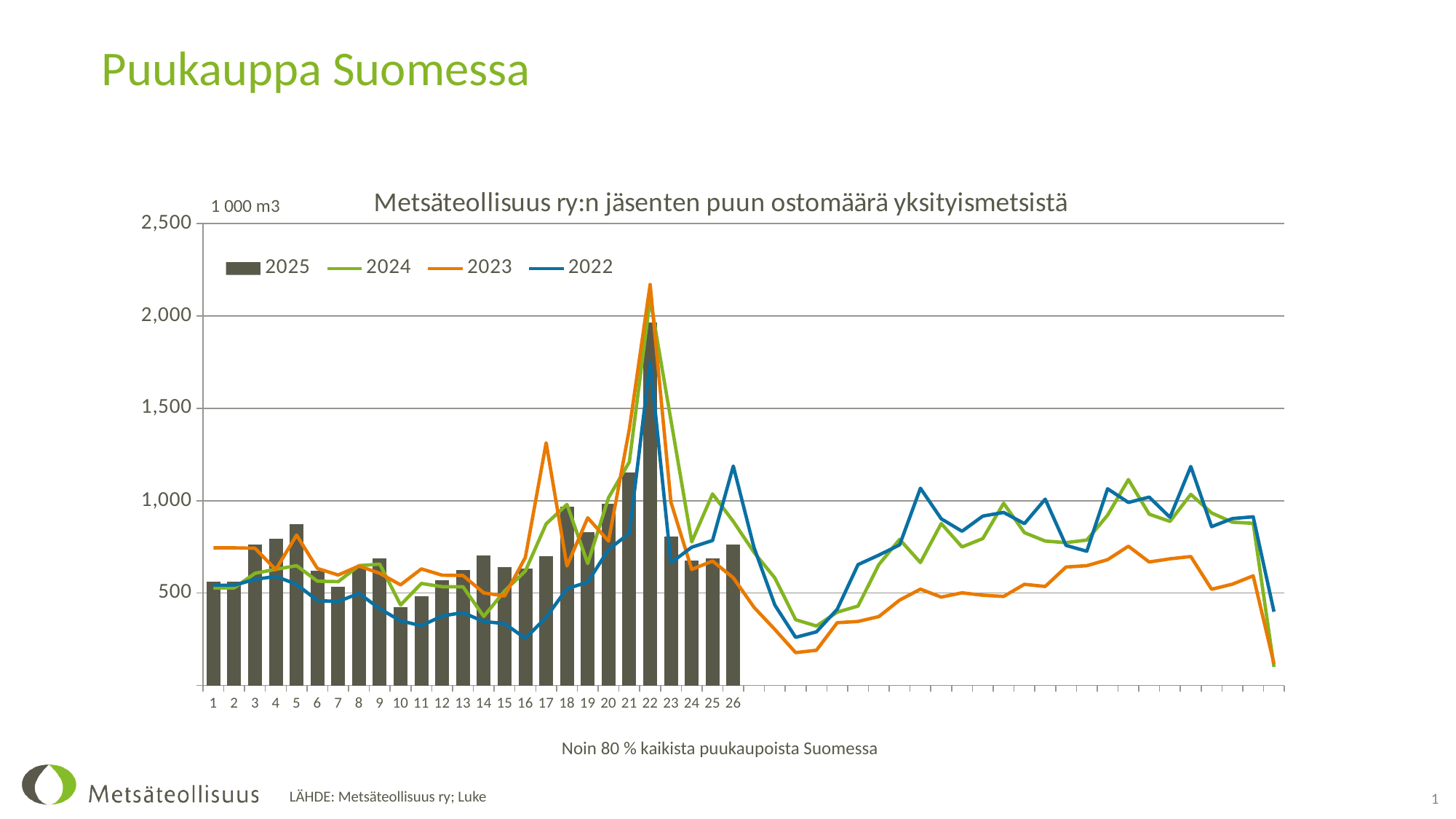
Is the 2023 line value at week 17 greater or less than 1,000? greater How many bars (weeks) are plotted for the 2025 series? 26 Is the 2023 line value at week 22 greater or less than 2,000? greater Which week has the highest 2025 bar? 22 Is the 2025 bar for week 10 greater or less than 500? less Do the 2025 bars rise or fall from week 19 to week 22? Rise What is the title of the chart? Metsäteollisuus ry:n jäsenten puun ostomäärä yksityismetsistä How many series does the legend list? 4 Which 2025 bar is larger, week 5 or week 7? Week 5 What kind of chart is shown on the slide? A combined bar and line chart Which series is drawn as bars rather than a line? 2025